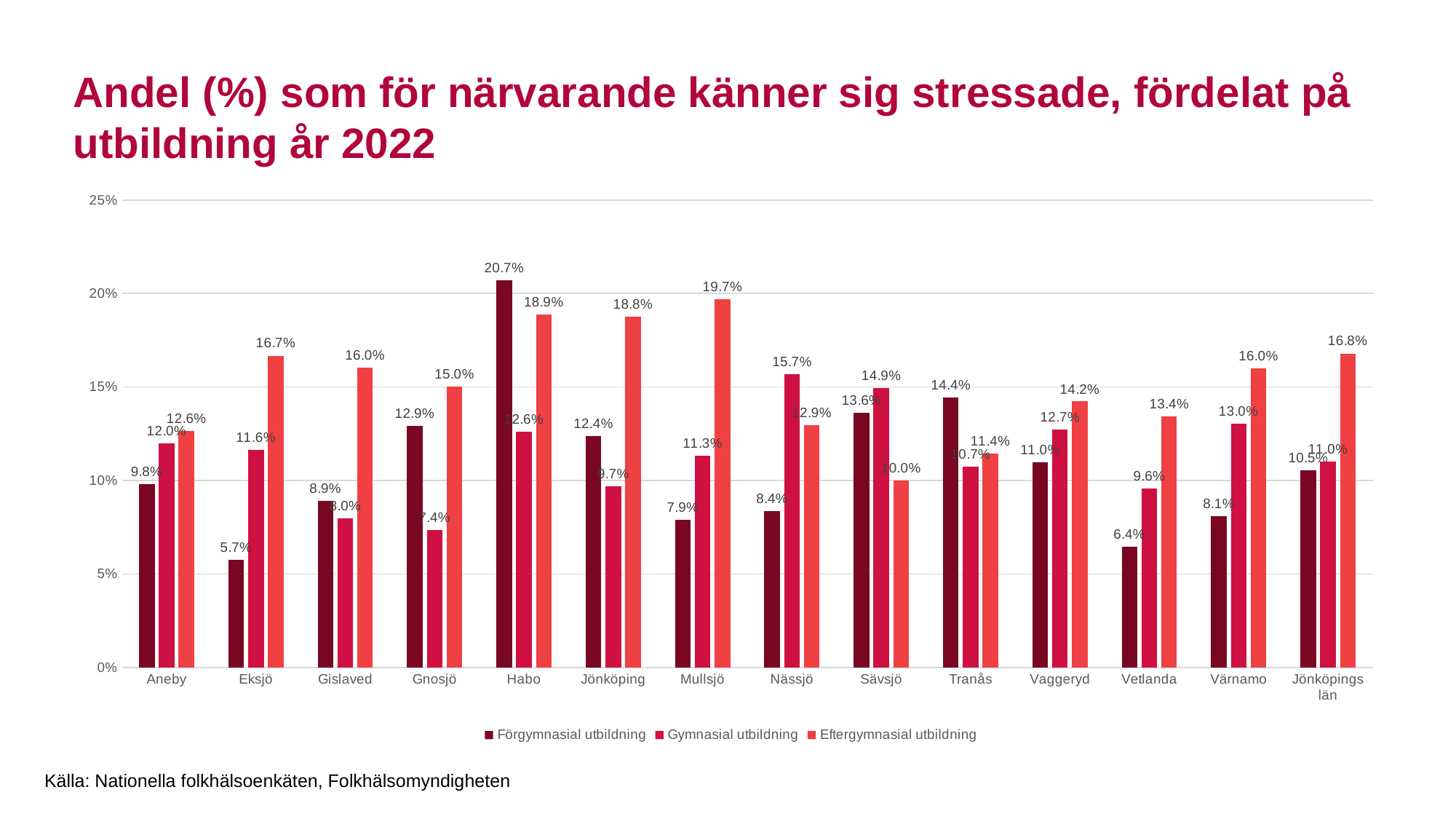
Which category has the lowest value for Förgymnasial utbildning? Eksjö How many series does the legend list? 3 Which category has the highest value for Förgymnasial utbildning? Habo What is the difference between Eftergymnasial utbildning and Förgymnasial utbildning in Eksjö? 11.0 percentage points What is the value for Förgymnasial utbildning in Habo? 20.7% What is the value for Eftergymnasial utbildning in Mullsjö? 19.7% What kind of chart is shown on the slide? Bar chart What is the value for Gymnasial utbildning in Nässjö? 15.7% How many categories are shown on the x axis? 14 What is the value for Eftergymnasial utbildning in Jönköpings län? 16.8% Which is larger in Sävsjö: Gymnasial utbildning or Eftergymnasial utbildning? Gymnasial utbildning Which category has the lowest value for Eftergymnasial utbildning? Sävsjö